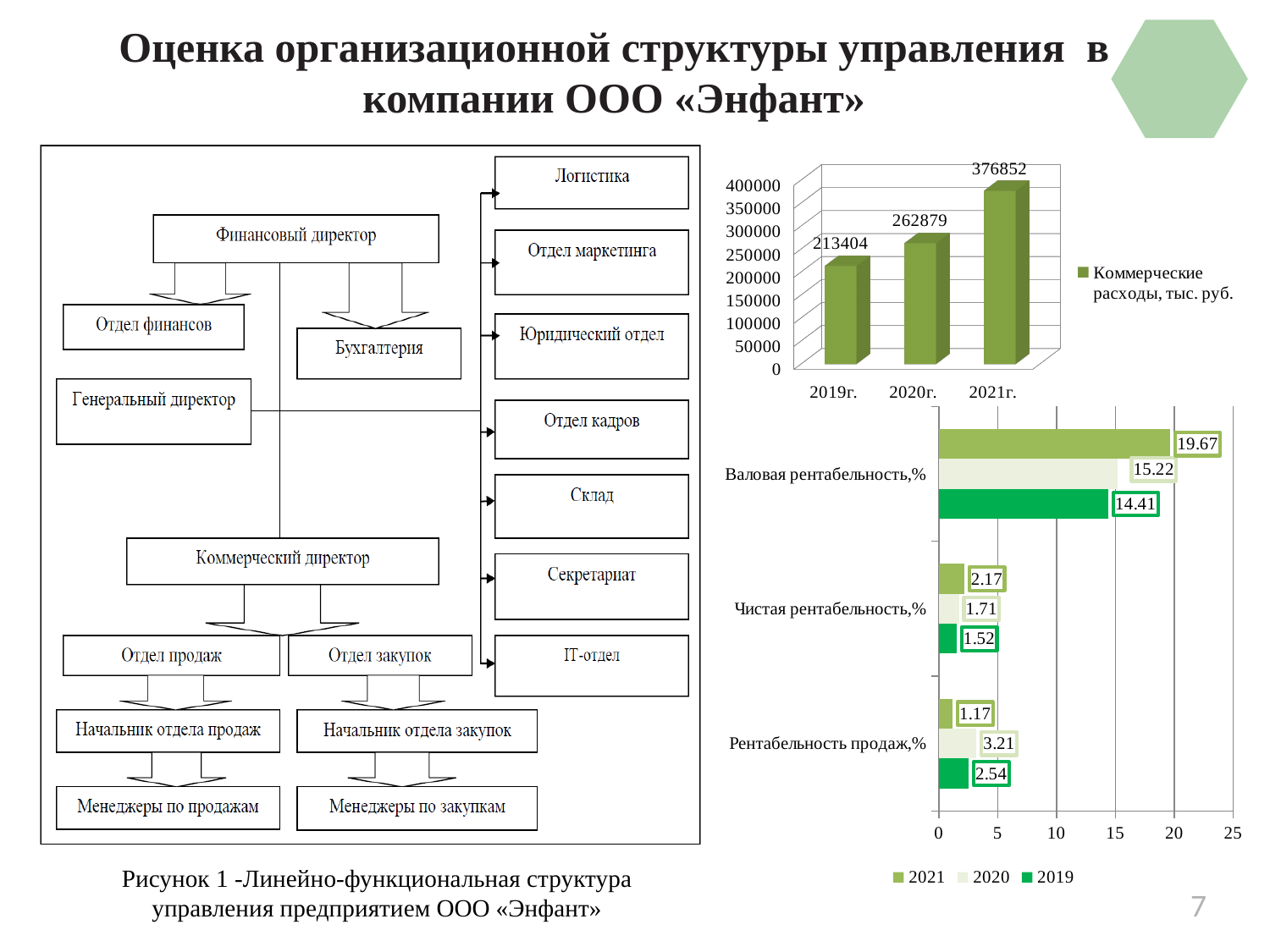
In the top-right chart of commercial expenses, what is the value for 2019г.? 213404 In the top-right chart of commercial expenses, what is the value for 2021г.? 376852 In the top-right chart of commercial expenses, do the values rise or fall from 2019г. to 2021г.? rise In the top-right chart, what is the legend entry for the plotted series? Коммерческие расходы, тыс. руб. In the bottom-right profitability chart, what is the 2021 value for Валовая рентабельность,%? 19.67 What kind of chart is the bottom-right profitability chart? bar chart In the bottom-right profitability chart, which year has the lowest value for Чистая рентабельность,%? 2019 In the top-right chart of commercial expenses, which year has the highest value? 2021г. In the bottom-right profitability chart, how many series does the legend list? 3 In the bottom-right profitability chart, what is the 2020 value for Рентабельность продаж,%? 3.21 In the top-right chart of commercial expenses, what is the difference between the 2021г. and 2020г. values? 113973 In the bottom-right profitability chart, what is the difference between the 2021 and 2019 values for Валовая рентабельность,%? 5.26